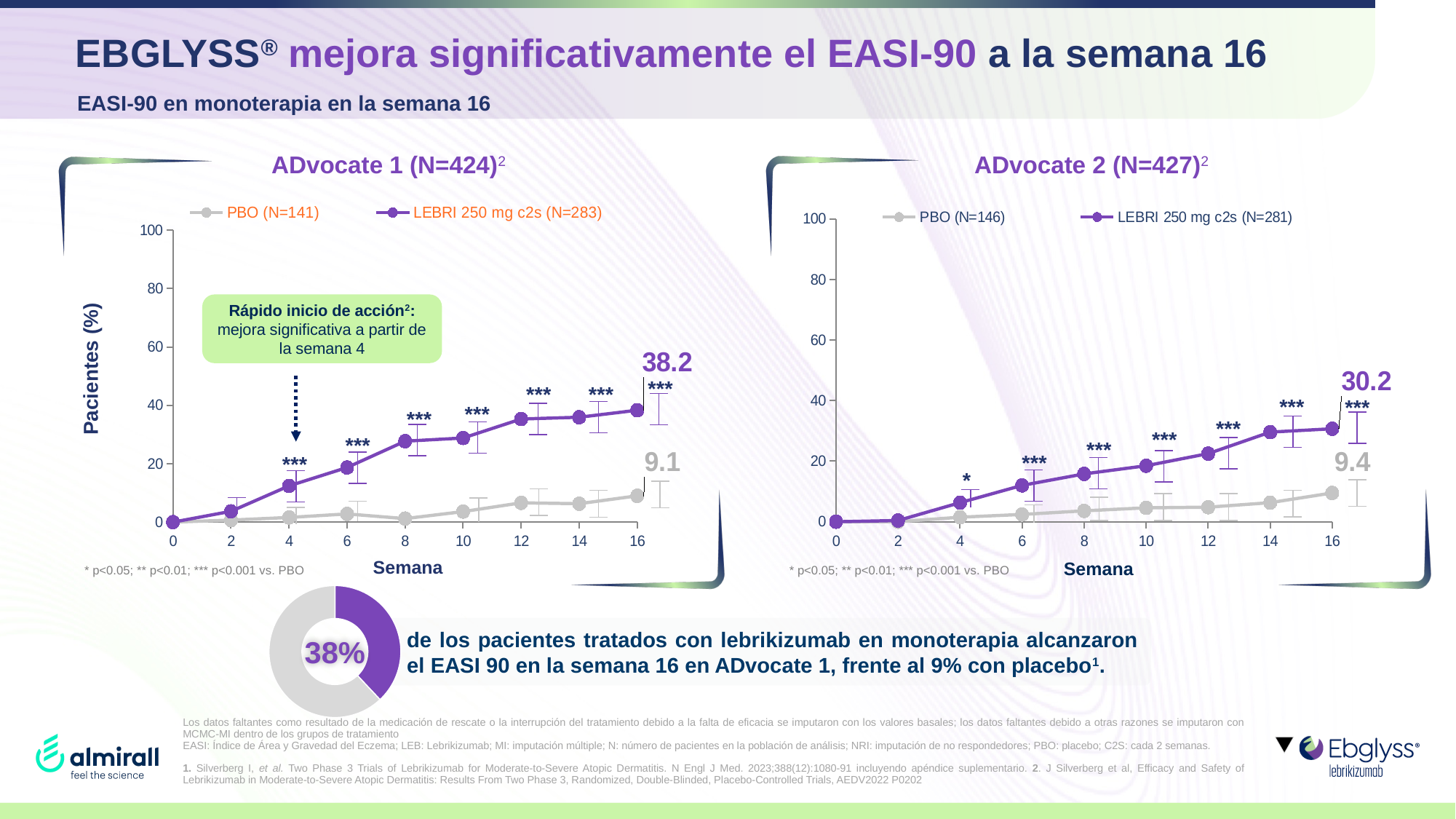
What percentage does the donut chart at the bottom of the slide show? 38% In the ADvocate 2 chart, what is the value for LEBRI 250 mg c2s at week 16? 30.2 What kind of chart is the ADvocate 2 chart? Line chart In the ADvocate 2 chart, what is the difference between the LEBRI 250 mg c2s and PBO values at week 16? 20.8 In the ADvocate 2 chart, which series has the higher value at week 16, PBO or LEBRI 250 mg c2s? LEBRI 250 mg c2s In the ADvocate 1 chart, what is the value for PBO at week 16? 9.1 In the ADvocate 1 chart, is the value for LEBRI 250 mg c2s at week 12 greater or less than 20? greater How many series does the legend of the ADvocate 1 chart list? 2 In the ADvocate 1 chart, what is the value for LEBRI 250 mg c2s at week 16? 38.2 In the ADvocate 2 chart, what is the value for PBO at week 16? 9.4 In the ADvocate 1 chart, does the LEBRI 250 mg c2s series rise or fall from week 0 to week 16? Rise In the ADvocate 1 chart, what is the difference between the LEBRI 250 mg c2s and PBO values at week 16? 29.1